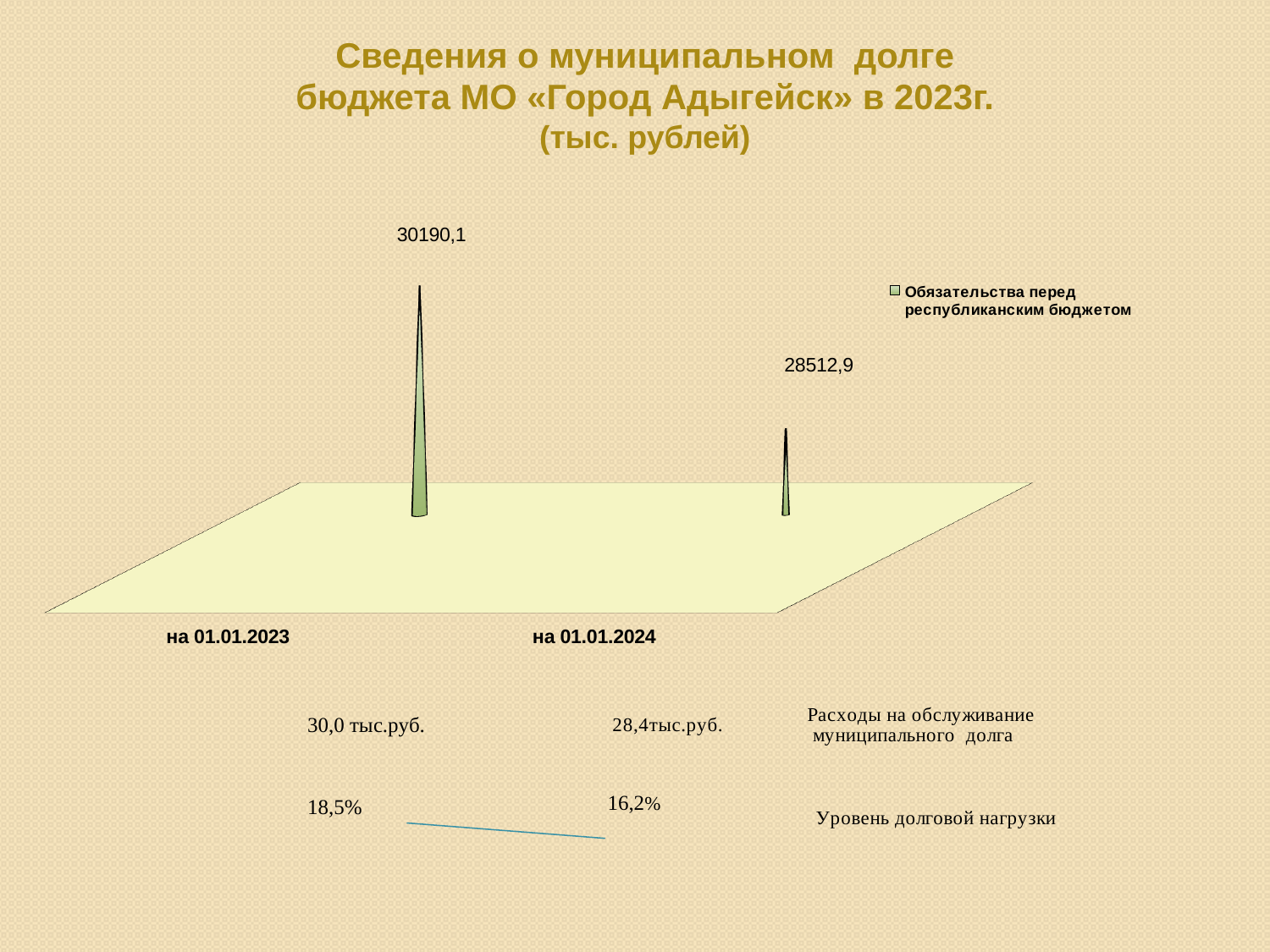
How many series does the chart legend list? 1 Do the values rise or fall from «на 01.01.2023» to «на 01.01.2024»? fall What kind of chart is shown on the slide? bar chart How many categories (dates) are shown on the chart's x axis? 2 Which date has the higher value in the chart? на 01.01.2023 What is the name of the series in the chart legend? Обязательства перед республиканским бюджетом Is the value for «на 01.01.2024» larger or smaller than the value for «на 01.01.2023»? smaller Which date has the lower value in the chart? на 01.01.2024 What is the difference between the values for «на 01.01.2023» and «на 01.01.2024»? 1677,2 What is the value for «на 01.01.2023» in the chart? 30190,1 What is the value for «на 01.01.2024» in the chart? 28512,9 In what units are the chart values given, according to the slide title? тыс. рублей